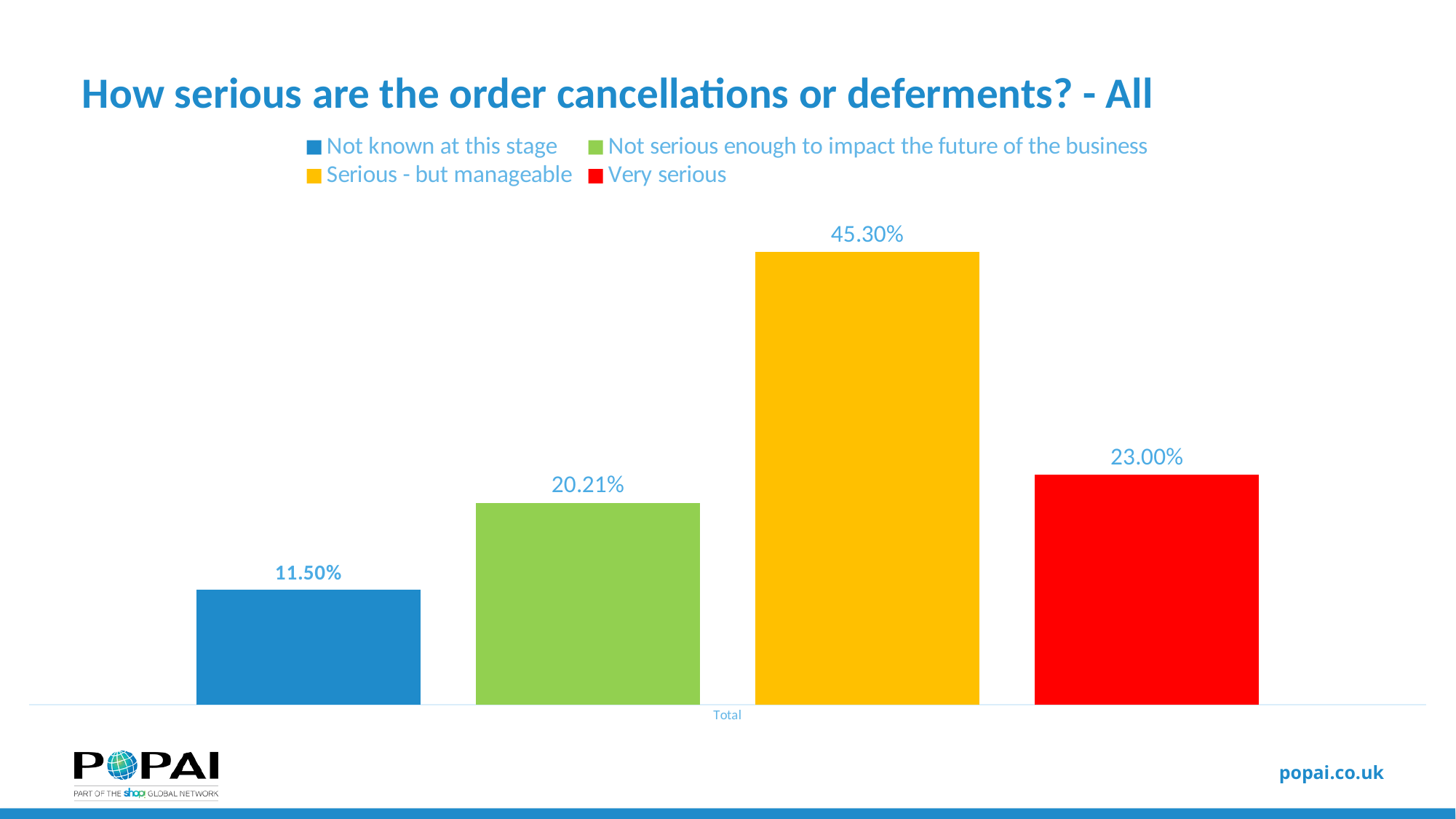
What kind of chart is shown on the slide? Bar chart What is the difference between 'Very serious' and 'Not known at this stage'? 11.50% Which is larger, 'Very serious' or 'Not serious enough to impact the future of the business'? Very serious What colour is the bar for 'Serious - but manageable'? Yellow What is the value for 'Not serious enough to impact the future of the business'? 20.21% What is the value for 'Very serious'? 23.00% What is the value for 'Not known at this stage'? 11.50% What is the difference between 'Serious - but manageable' and 'Very serious'? 22.30% What is the value for 'Serious - but manageable'? 45.30% Which series has the lowest value? Not known at this stage Which series has the highest value? Serious - but manageable How many series does the legend list? 4